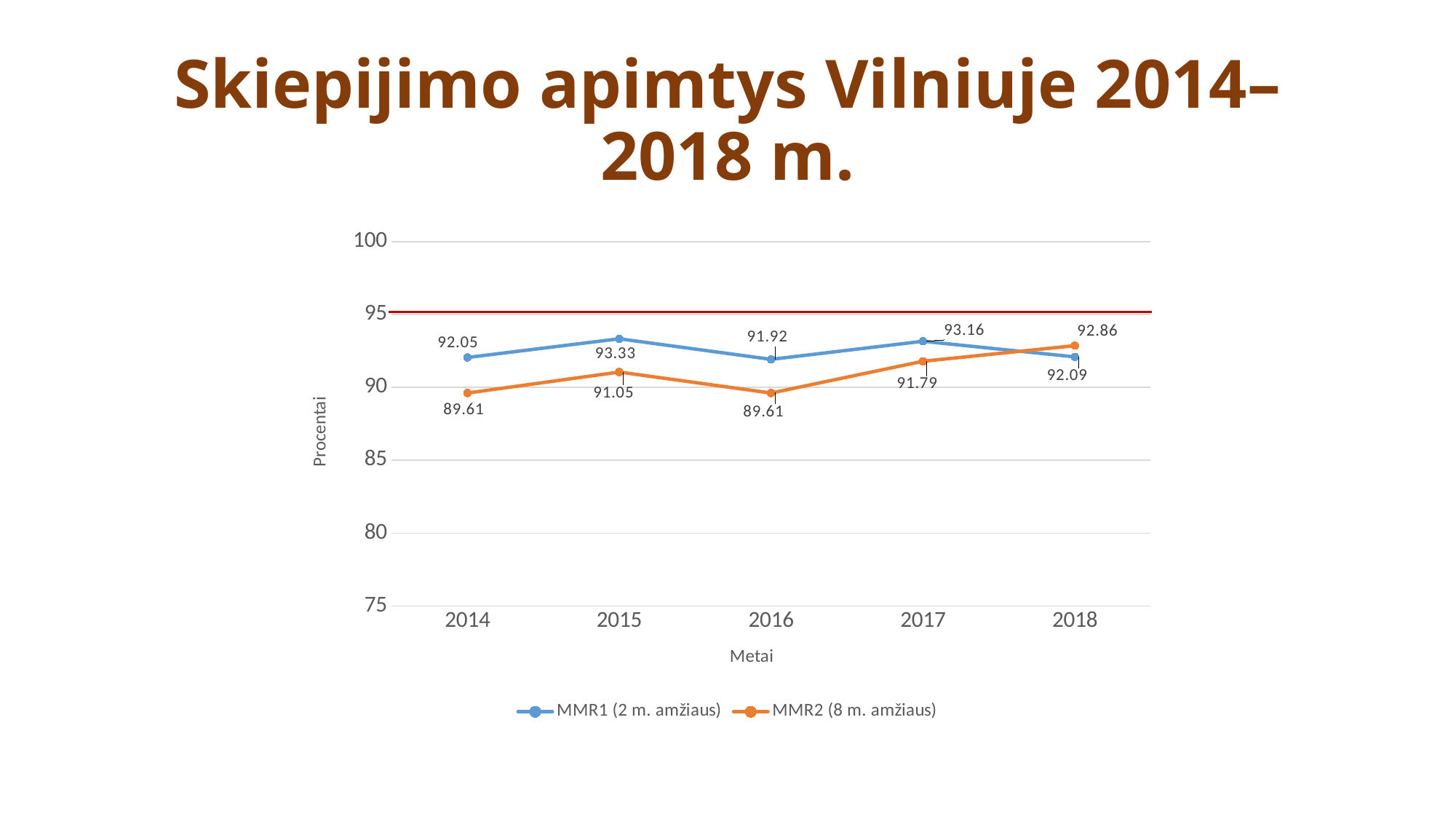
What is the value for MMR1 (2 m. amžiaus) in 2015? 93.33 How many series does the legend list? 2 Does the MMR2 (8 m. amžiaus) value rise or fall from 2016 to 2018? rise In which year is the MMR1 (2 m. amžiaus) value lowest? 2016 How many years are shown on the x axis? 5 What is the difference between the MMR1 and MMR2 values in 2014? 2.44 What is the value for MMR2 (8 m. amžiaus) in 2017? 91.79 What kind of chart is shown on the slide? line chart Which series has the larger value in 2018, MMR1 (2 m. amžiaus) or MMR2 (8 m. amžiaus)? MMR2 (8 m. amžiaus) In which year is the MMR1 (2 m. amžiaus) value highest? 2015 In which year is the MMR2 (8 m. amžiaus) value highest? 2018 What is the value for MMR1 (2 m. amžiaus) in 2018? 92.09